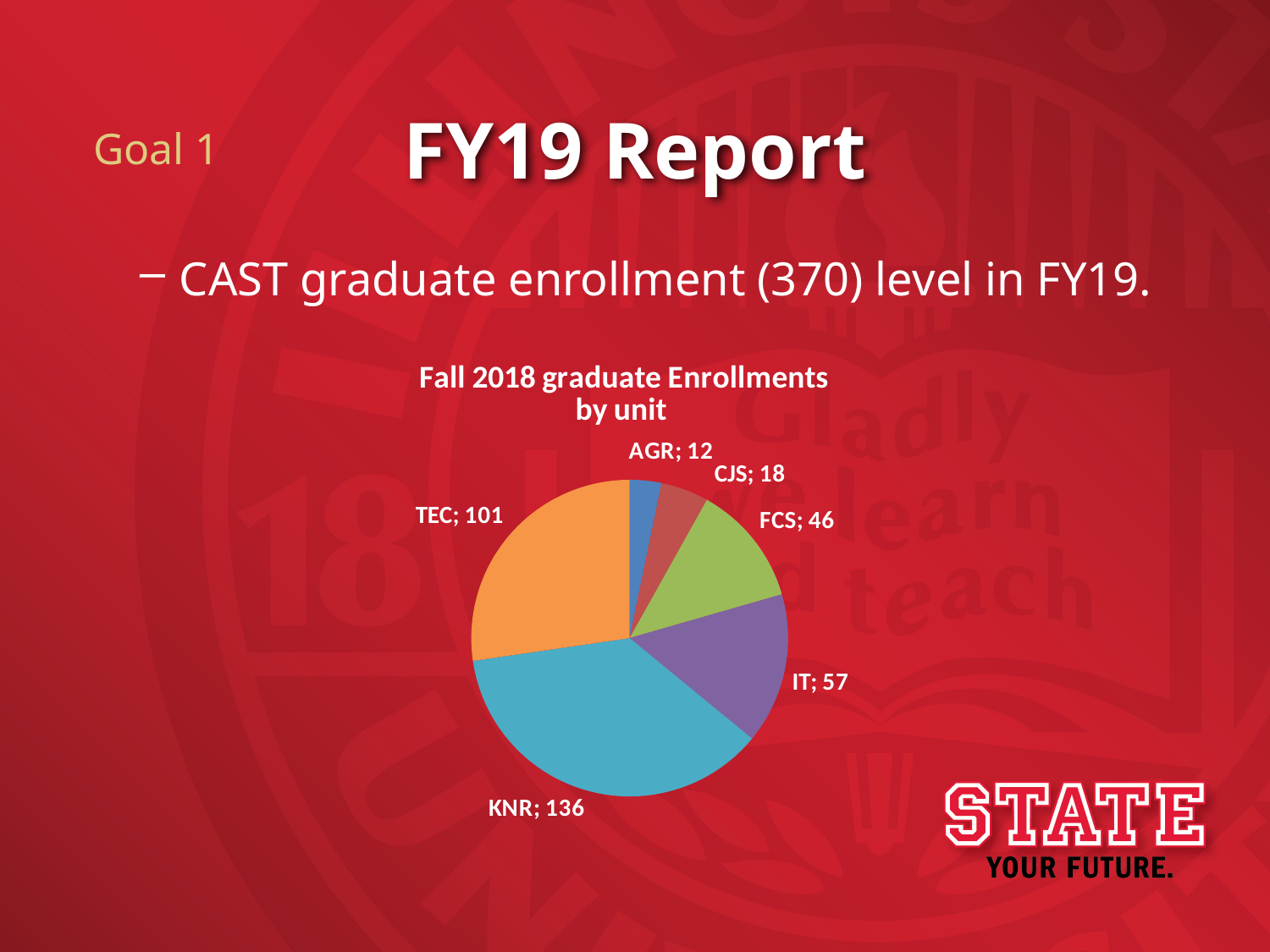
How many units (slices) are shown in the pie chart? 6 What is the difference between the enrollments for KNR and TEC? 35 What is the enrollment value for FCS? 46 What is the title of the chart? Fall 2018 graduate Enrollments by unit Which has a larger enrollment, IT or FCS? IT What is the enrollment value for AGR? 12 What is the enrollment value for TEC? 101 What is the enrollment value for KNR? 136 Which unit has the lowest enrollment? AGR What is the total enrollment across all units in the pie chart? 370 What type of chart is shown on the slide? pie chart Which unit has the highest enrollment? KNR